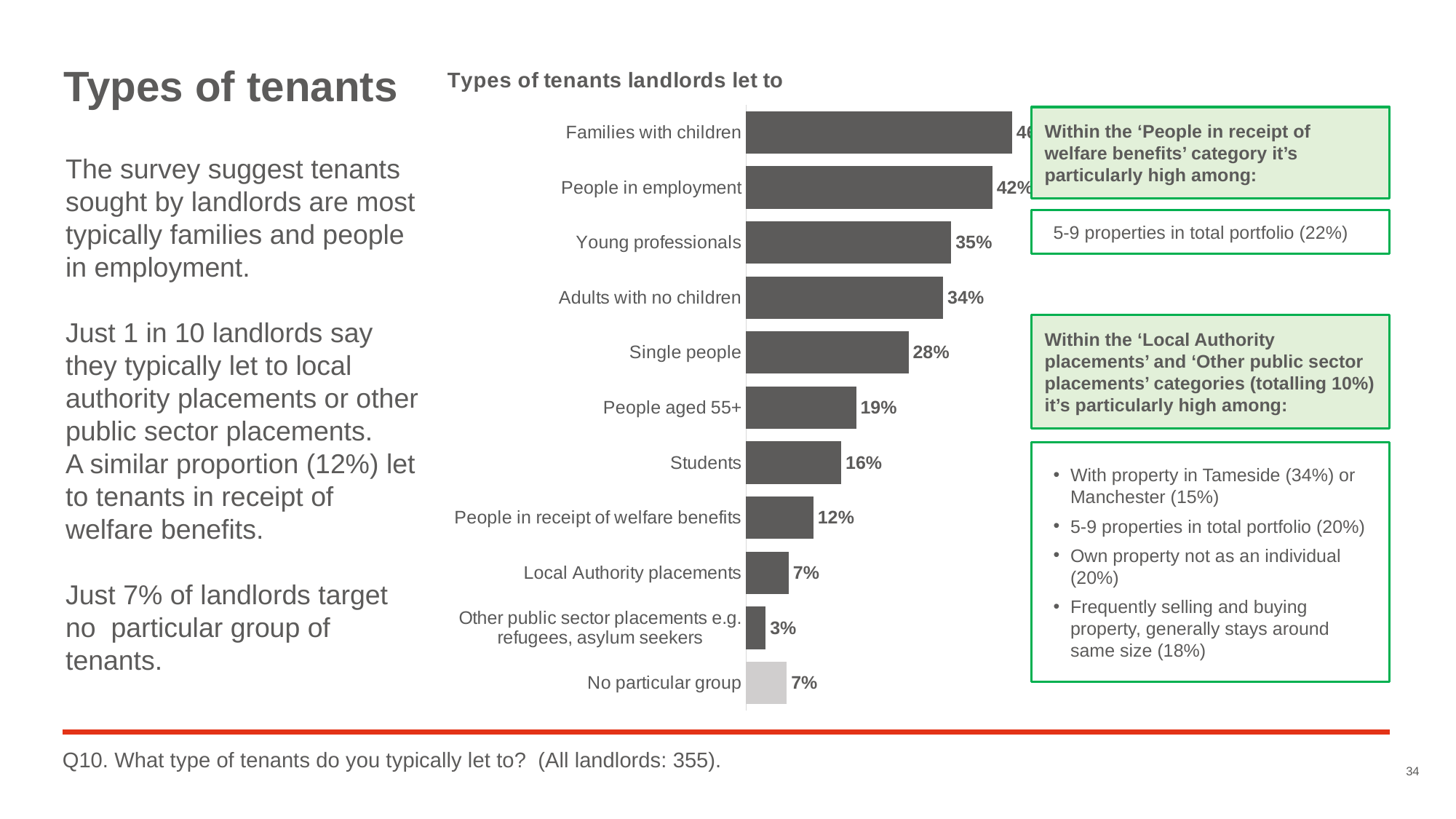
Which category has the lowest value in the chart? Other public sector placements e.g. refugees, asylum seekers What type of chart is used on the slide? bar chart How many categories are shown in the chart? 11 What percentage of landlords typically let to young professionals? 35% What is the difference between the values for 'Single people' and 'People aged 55+'? 9% Which category has the highest value in the chart? Families with children What is the value for 'Adults with no children'? 34% What is the combined value of 'Local Authority placements' and 'Other public sector placements e.g. refugees, asylum seekers'? 10% What is the value for 'Other public sector placements e.g. refugees, asylum seekers'? 3% Which is larger: the value for 'Students' or the value for 'People aged 55+'? People aged 55+ What is the value for 'People in receipt of welfare benefits'? 12% What is the title of the chart? Types of tenants landlords let to